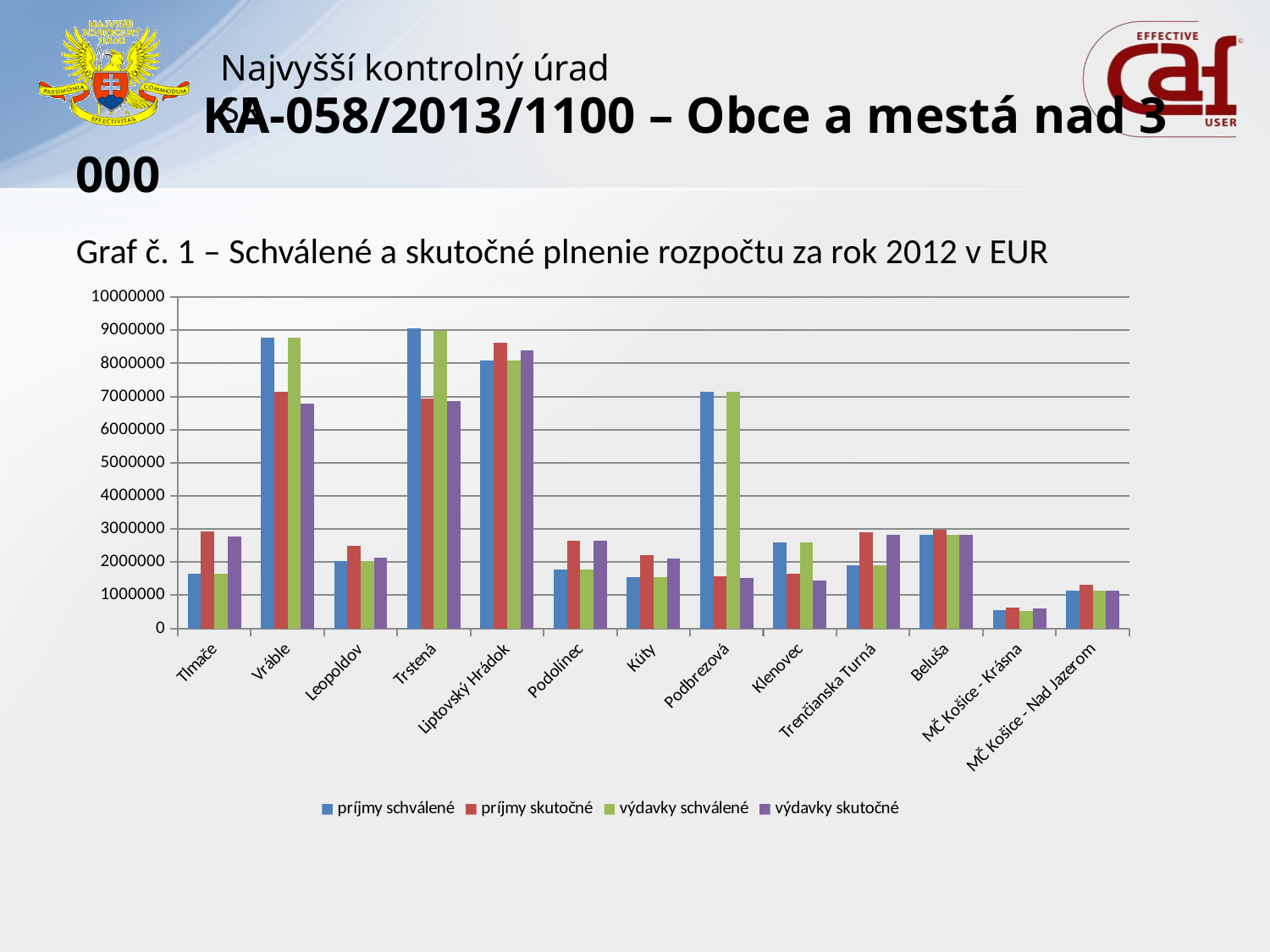
For Podbrezová, which is larger: príjmy schválené or príjmy skutočné? príjmy schválené Is the value of príjmy schválené for Vráble greater or less than 8000000? greater Is the value of príjmy skutočné for Podbrezová greater or less than 2000000? less How many series does the chart legend list? 4 Which municipality has the highest value for príjmy schválené? Trstená How many municipalities (categories) are shown on the x axis of the chart? 13 Is the value of výdavky skutočné for Liptovský Hrádok greater or less than 8000000? greater Which has the larger value of príjmy skutočné: Trstená or Liptovský Hrádok? Liptovský Hrádok Which municipality has the lowest value for príjmy schválené? MČ Košice - Krásna What kind of chart is shown on the slide? bar chart What is the title of the chart? Graf č. 1 – Schválené a skutočné plnenie rozpočtu za rok 2012 v EUR